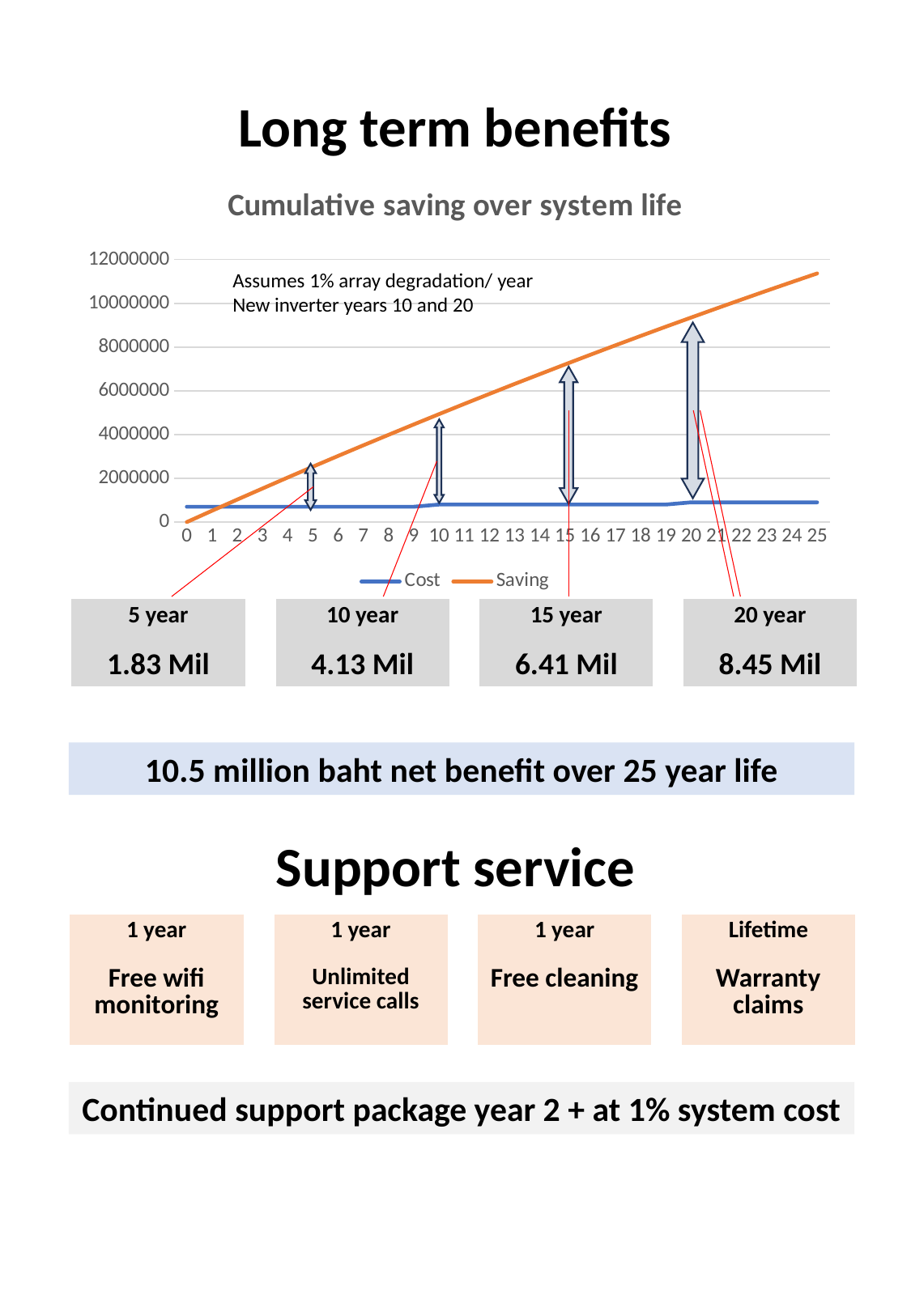
In the 'Cumulative saving over system life' chart, does the Saving line rise or fall as the years increase? Rise In the 'Cumulative saving over system life' chart, is the Cost value at year 25 greater or less than 2000000? less In the 'Cumulative saving over system life' chart, is the Saving value at year 10 greater or less than 6000000? less In the 'Cumulative saving over system life' chart, which series has the larger value at year 20, Cost or Saving? Saving How many series does the legend of the 'Cumulative saving over system life' chart list? 2 What is the last year shown on the x axis of the 'Cumulative saving over system life' chart? 25 According to the callout box below the chart, what is the cumulative net benefit at 20 years? 8.45 Mil Using the callout boxes below the chart, what is the difference between the 20 year value and the 5 year value? 6.62 Mil What are the two series named in the legend of the 'Cumulative saving over system life' chart? Cost and Saving In the 'Cumulative saving over system life' chart, is the Saving value at year 25 greater or less than 10000000? greater According to the callout box below the chart, what is the cumulative net benefit at 5 years? 1.83 Mil What kind of chart is shown under 'Cumulative saving over system life'? Line chart